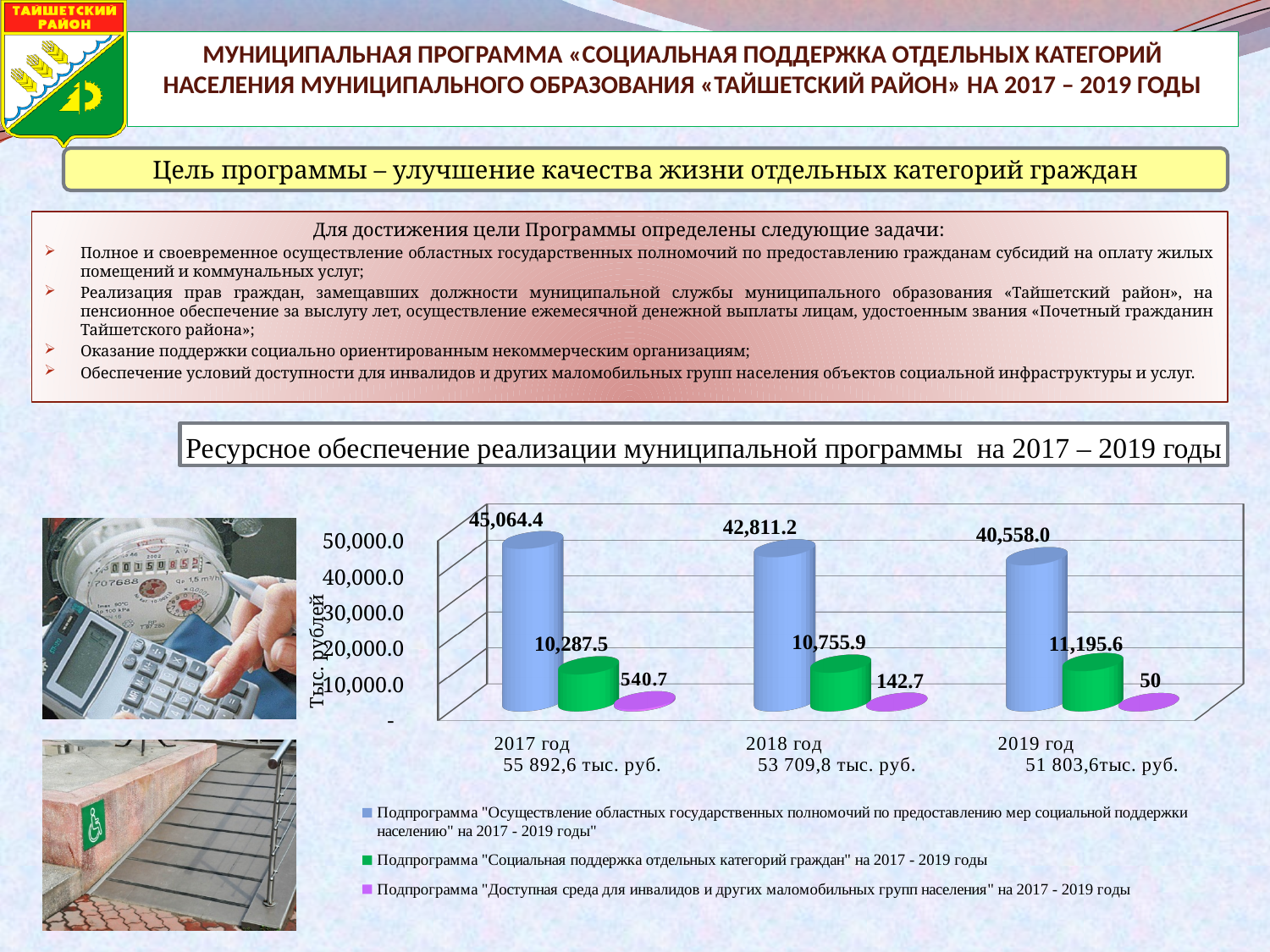
What is the value for the subprogram "Осуществление областных государственных полномочий по предоставлению мер социальной поддержки населению" in 2017 год? 45,064.4 How many series does the chart legend list? 3 In which year is the value for the subprogram "Социальная поддержка отдельных категорий граждан" the highest? 2019 год What is the difference between the 2017 and 2019 values for the subprogram "Осуществление областных государственных полномочий по предоставлению мер социальной поддержки населению"? 4,506.4 What is the value for the subprogram "Доступная среда для инвалидов и других маломобильных групп населения" in 2019 год? 50 In which year is the value for the subprogram "Осуществление областных государственных полномочий по предоставлению мер социальной поддержки населению" the lowest? 2019 год Which is larger: the 2017 value or the 2018 value for the subprogram "Доступная среда для инвалидов и других маломобильных групп населения"? 2017 год What is the value for the subprogram "Социальная поддержка отдельных категорий граждан" in 2018 год? 10,755.9 Does the value for the subprogram "Осуществление областных государственных полномочий по предоставлению мер социальной поддержки населению" rise or fall from 2017 to 2019? fall What unit is shown on the vertical axis of the chart? Тыс. рублей What type of chart is shown on the slide? bar chart How many year categories are shown on the x axis of the chart? 3